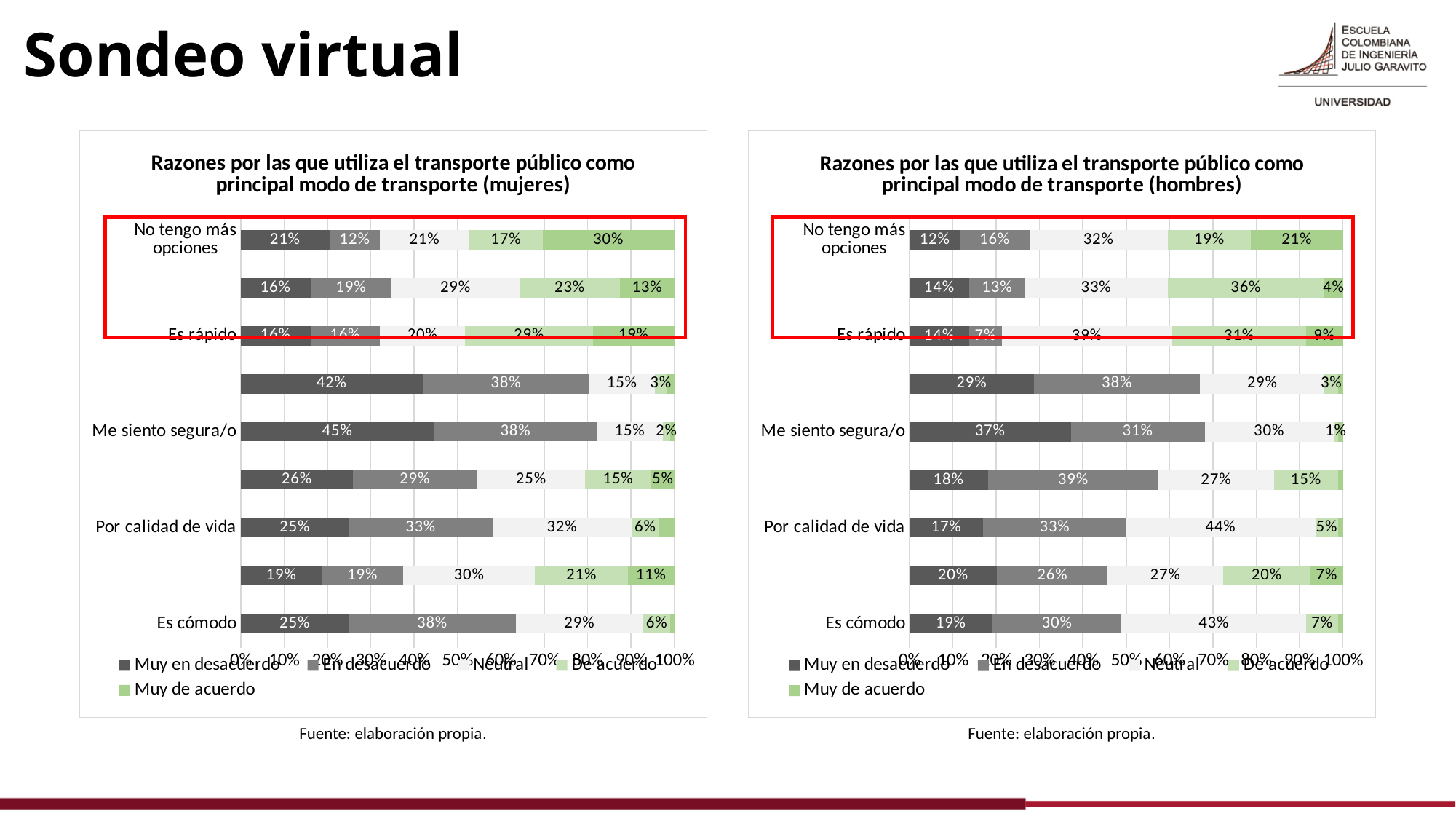
Comparing the two charts, is the "Muy en desacuerdo" share for "Me siento segura/o" larger for mujeres or for hombres? Mujeres In the chart for mujeres (left), what percentage of respondents answered "Muy de acuerdo" for "No tengo más opciones"? 30% In the chart for mujeres (left), which response category has the largest share for "Me siento segura/o"? Muy en desacuerdo How many series does the legend of the left chart (mujeres) list? 5 What is the title of the right chart? Razones por las que utiliza el transporte público como principal modo de transporte (hombres) In the chart for hombres (right), what is the "En desacuerdo" value for "Es cómodo"? 30% In the chart for mujeres (left), what is the difference between the "Muy de acuerdo" and "Muy en desacuerdo" values for "No tengo más opciones"? 9% In the chart for mujeres (left), what is the "Muy en desacuerdo" value for "Me siento segura/o"? 45% In the chart for hombres (right), which response category has the largest share for "Es cómodo"? Neutral In the chart for hombres (right), what percentage answered "Neutral" for "Por calidad de vida"? 44% In the chart for hombres (right), what is the difference between the "Neutral" and "Muy en desacuerdo" values for "Es rápido"? 25% What kind of chart is the right chart (hombres)? Stacked bar chart